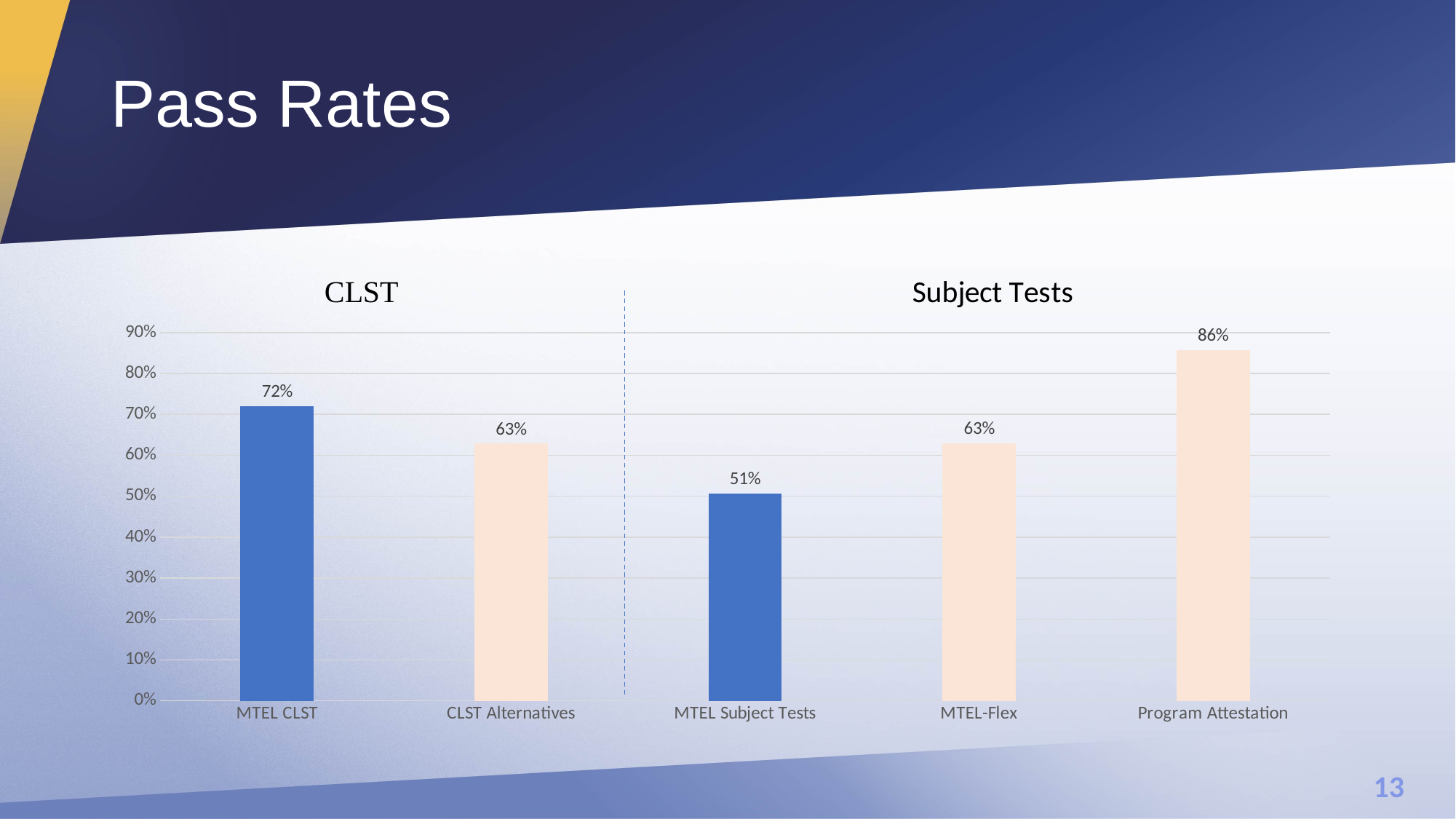
Which category has the highest pass rate? Program Attestation What is the pass rate for MTEL CLST? 72% Which has a higher pass rate, MTEL CLST or MTEL Subject Tests? MTEL CLST What kind of chart is shown on the slide? Bar chart What is the pass rate for MTEL-Flex? 63% What is the pass rate for Program Attestation? 86% What is the difference between the pass rates for MTEL CLST and CLST Alternatives? 9% How many categories are shown on the chart? 5 What are the two group headings shown above the chart? CLST and Subject Tests Which category has the lowest pass rate? MTEL Subject Tests What is the pass rate for MTEL Subject Tests? 51% What is the difference between the pass rates for Program Attestation and MTEL Subject Tests? 35%